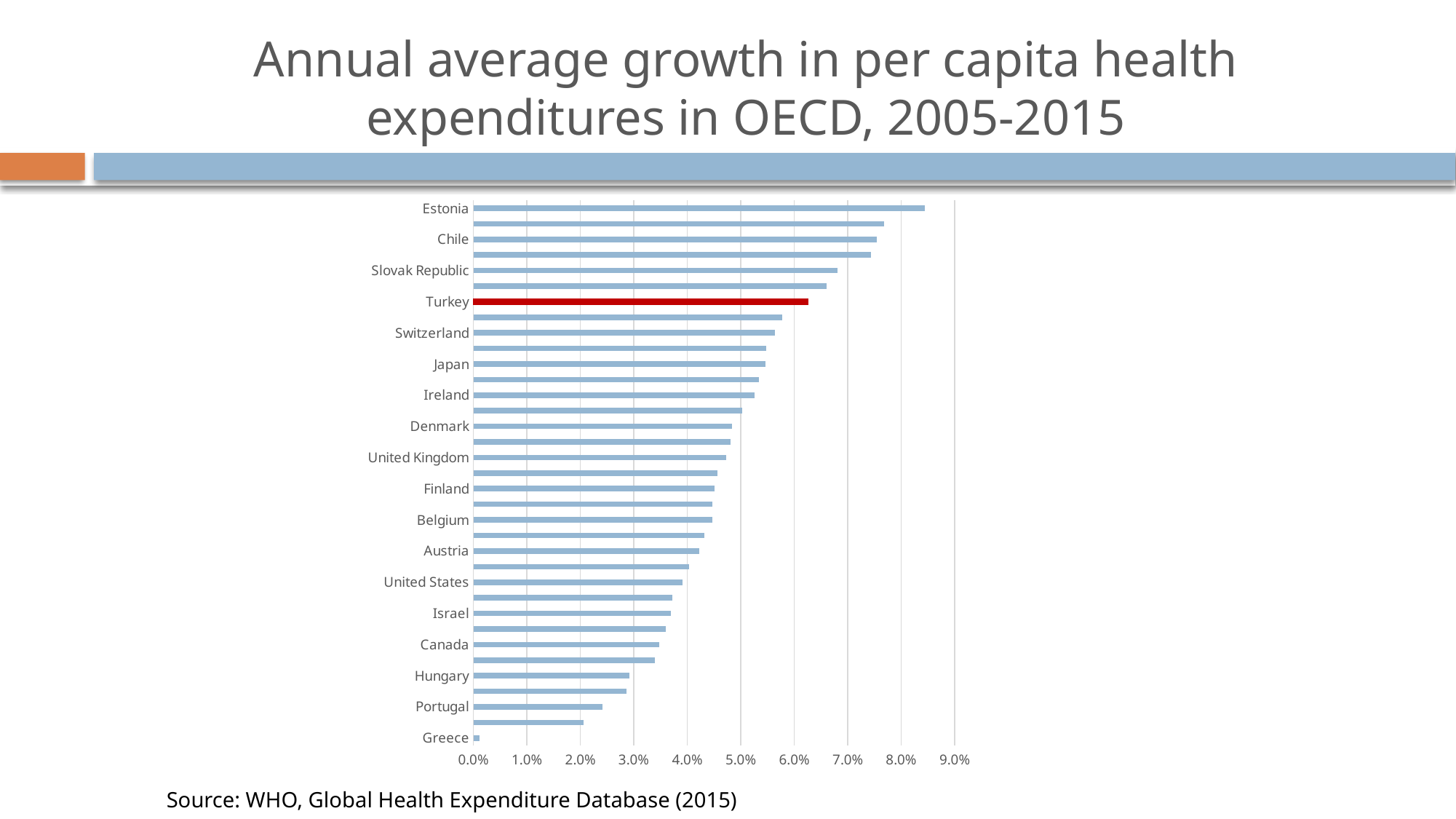
Which country's bar is highlighted in red? Turkey Which country has the highest annual average growth in per capita health expenditures? Estonia Which has a higher value, Turkey or Switzerland? Turkey Is the value for Portugal greater or less than 3.0%? less Is the value for Canada greater or less than 4.0%? less Is the value for Estonia greater or less than 8.0%? greater Which has a higher value, Chile or Japan? Chile What kind of chart is shown on the slide? bar chart Which country has the lowest annual average growth in per capita health expenditures? Greece